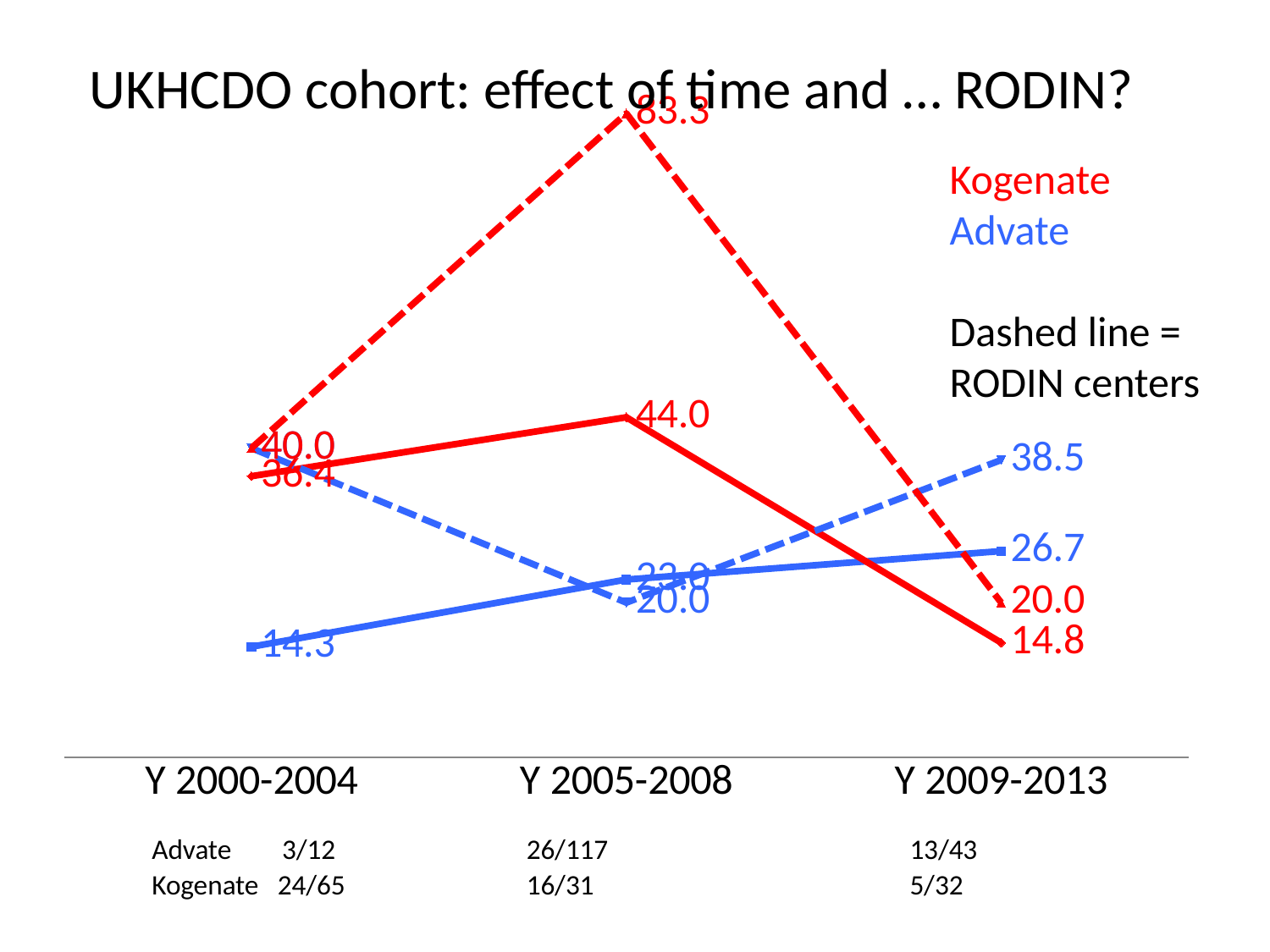
What kind of chart is shown on the slide? line chart What is the value of the solid Advate line for Y 2000-2004? 14.3 What is the value of the dashed Kogenate (RODIN centers) line for Y 2005-2008? 83.3 According to the slide, what do the dashed lines represent? RODIN centers How many time periods are shown on the x axis? 3 What is the value of the solid Kogenate line for Y 2005-2008? 44.0 What is the value of the dashed Advate (RODIN centers) line for Y 2009-2013? 38.5 What is the difference between the solid Kogenate values for Y 2005-2008 and Y 2009-2013? 29.2 What is the value of the solid Kogenate line for Y 2009-2013? 14.8 Does the solid Advate line rise or fall from Y 2000-2004 to Y 2009-2013? rise Which time period has the highest value on the dashed Kogenate line? Y 2005-2008 For Y 2009-2013, which is larger: the dashed Kogenate value or the solid Kogenate value? dashed Kogenate (20.0)